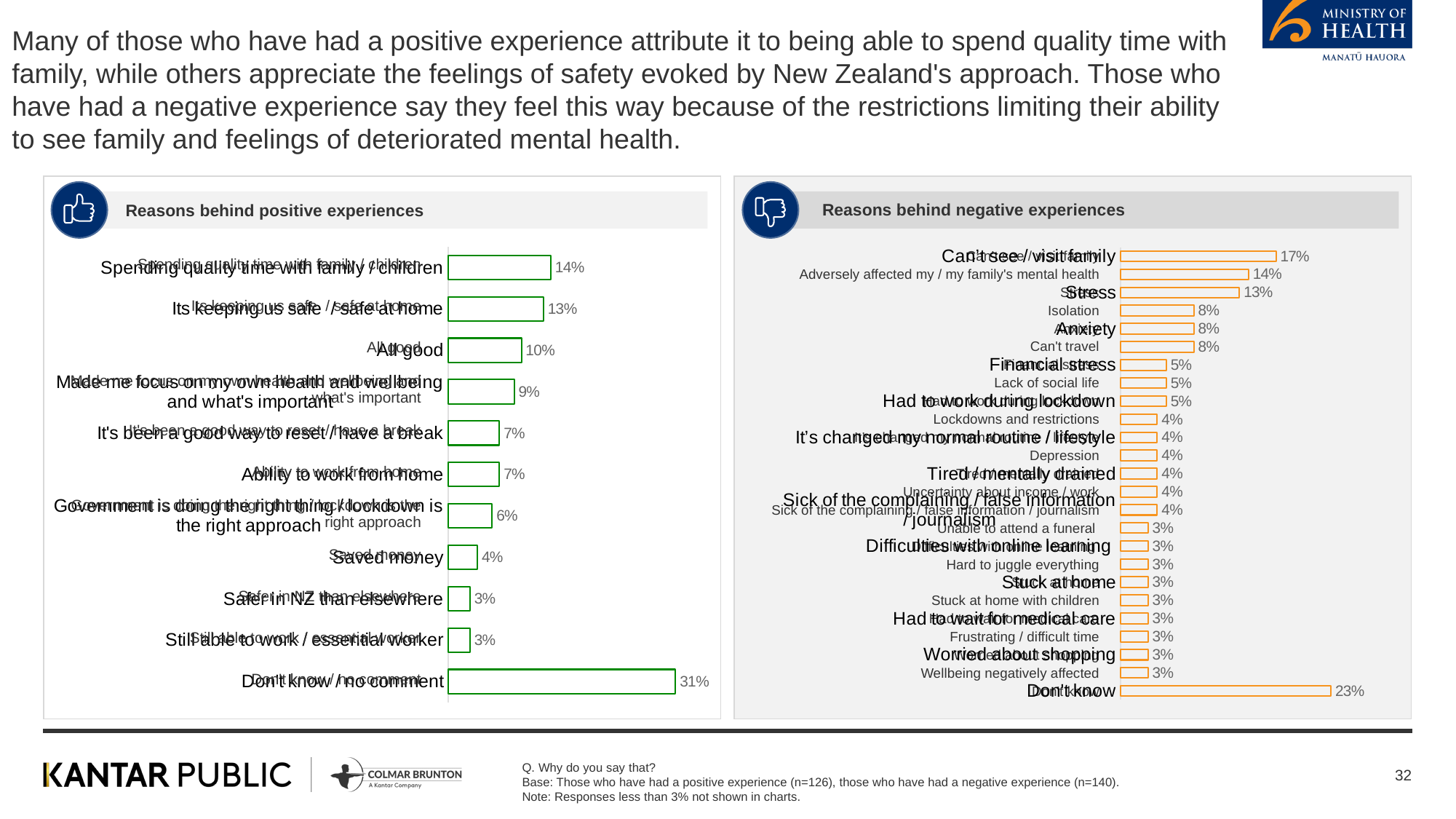
In the 'Reasons behind negative experiences' chart, which is larger: 'Isolation' or 'Financial stress'? Isolation In the 'Reasons behind positive experiences' chart, what percentage is shown for 'Spending quality time with family / children'? 14% In the 'Reasons behind positive experiences' chart, which is larger: 'Ability to work from home' or 'Government is doing the right thing / lockdown is the right approach'? Ability to work from home In the 'Reasons behind negative experiences' chart, what is the difference between 'Can't see / visit family' and 'Adversely affected my / my family's mental health'? 3% In the 'Reasons behind negative experiences' chart, what percentage is shown for 'Can't see / visit family'? 17% In the 'Reasons behind positive experiences' chart, what percentage is shown for 'Don't know / no comment'? 31% In the 'Reasons behind positive experiences' chart, what is the value for 'Saved money'? 4% What type of chart is used for 'Reasons behind positive experiences'? Bar chart How many categories are shown in the 'Reasons behind positive experiences' chart? 11 In the 'Reasons behind positive experiences' chart, what is the difference between 'Its keeping us safe / safe at home' and 'All good'? 3% In the 'Reasons behind negative experiences' chart, what is the value for 'Don't know'? 23% In the 'Reasons behind negative experiences' chart, what is the value for 'Stress'? 13%